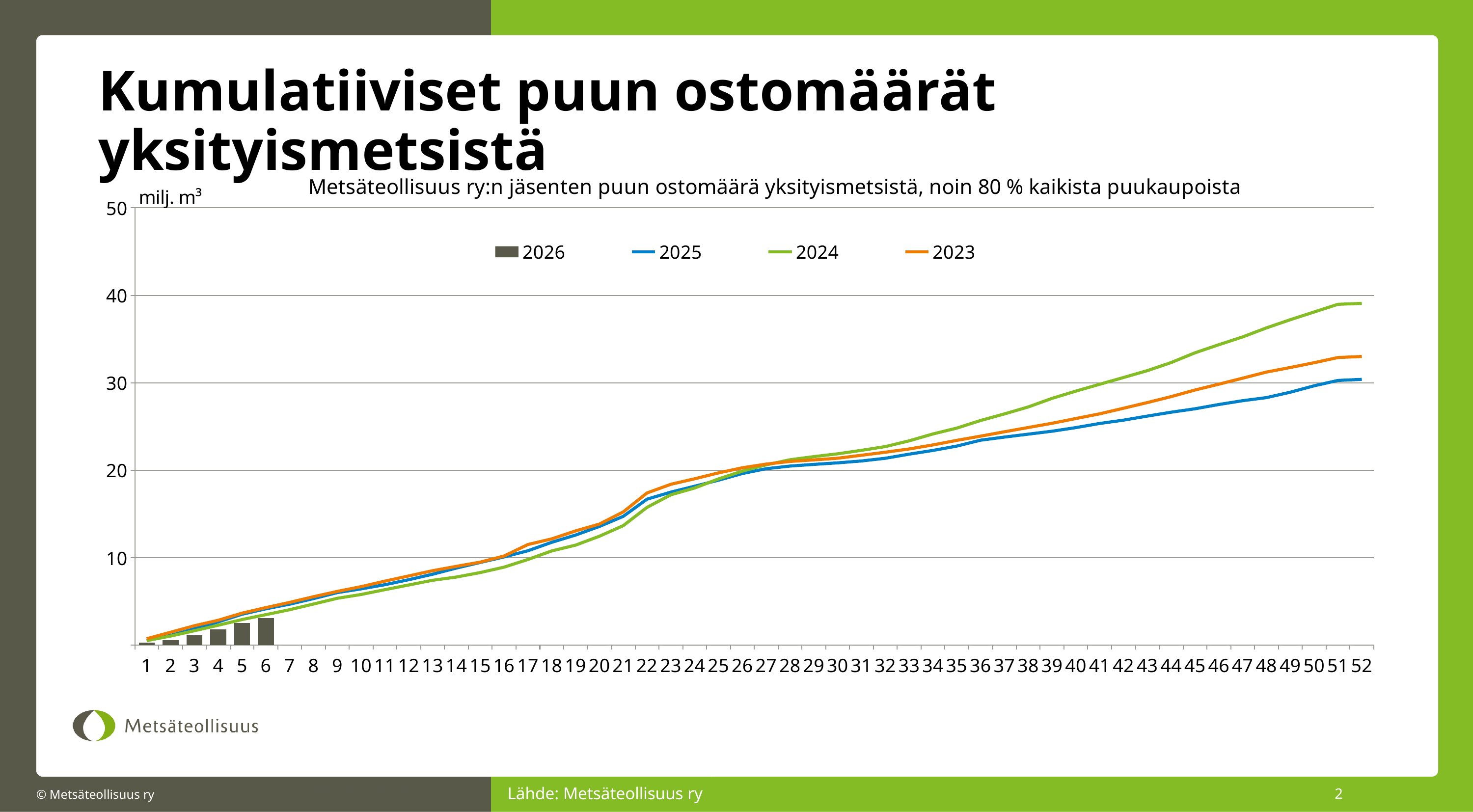
How many series does the chart legend list? 4 Which series has the lowest value at week 20? 2024 How many weeks are shown on the x axis of the chart? 52 How many bars are plotted for the 2026 series? 6 Which series has the highest value at week 52? 2024 Is the value for 2024 at week 52 greater or less than 30? greater Is the value for 2024 at week 20 greater or less than 20? less At week 52, which is larger: the value for 2024 or the value for 2025? 2024 Do the line series values rise or fall along the x axis? Rise What kind of chart is shown on the slide? A combination of a bar chart and a line chart Which series has the lowest value at week 52? 2025 What unit is shown on the y axis of the chart? milj. m³